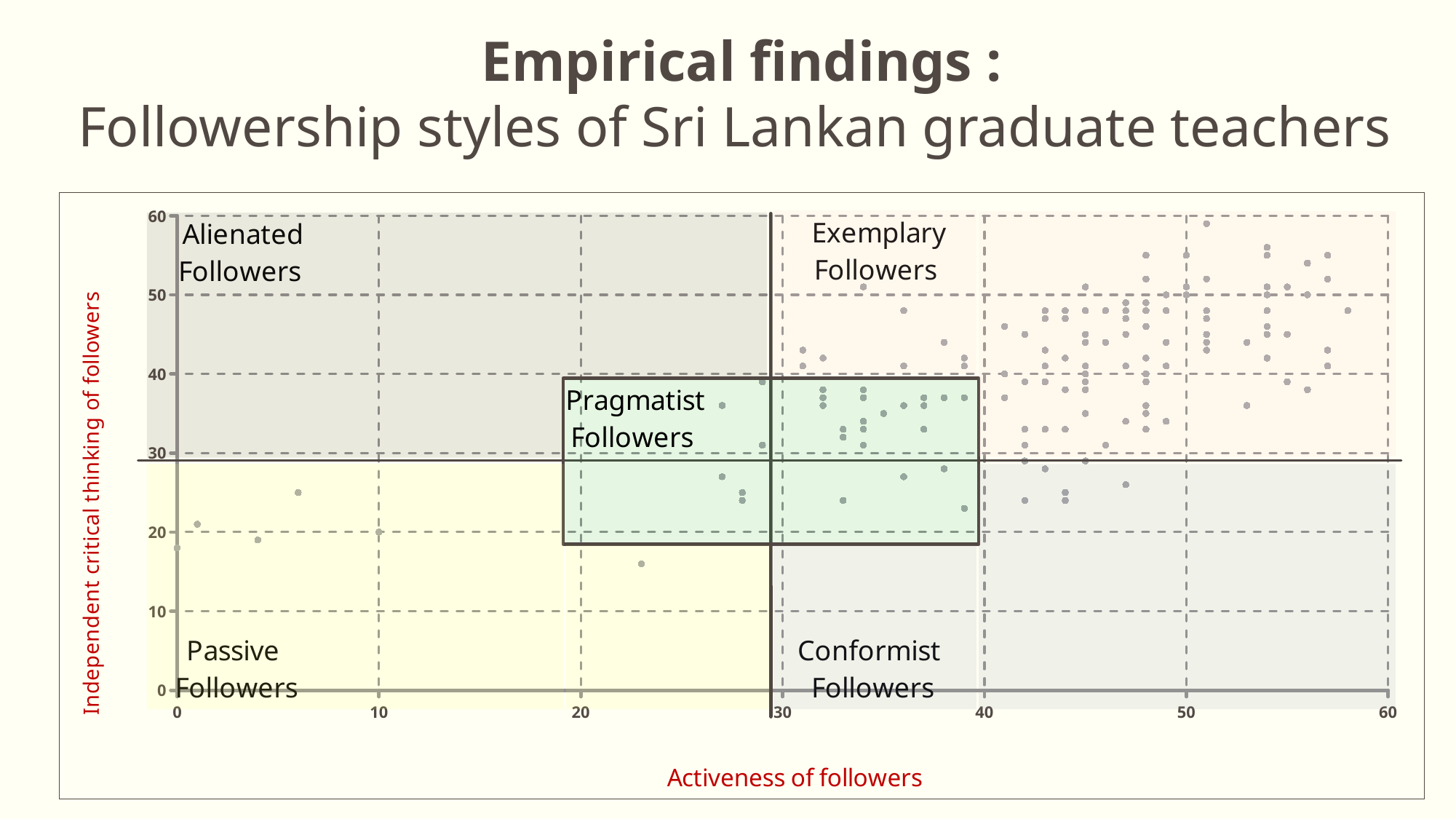
Which quadrant contains more data points, Exemplary Followers or Alienated Followers? Exemplary Followers What is the label of the y axis? Independent critical thinking of followers Which quadrant contains the fewest data points? Alienated Followers Which quadrant contains the most data points? Exemplary Followers Which quadrant contains more data points, Passive Followers or Conformist Followers? Conformist Followers What is the label of the x axis? Activeness of followers What kind of chart is shown on the slide? Scatter plot